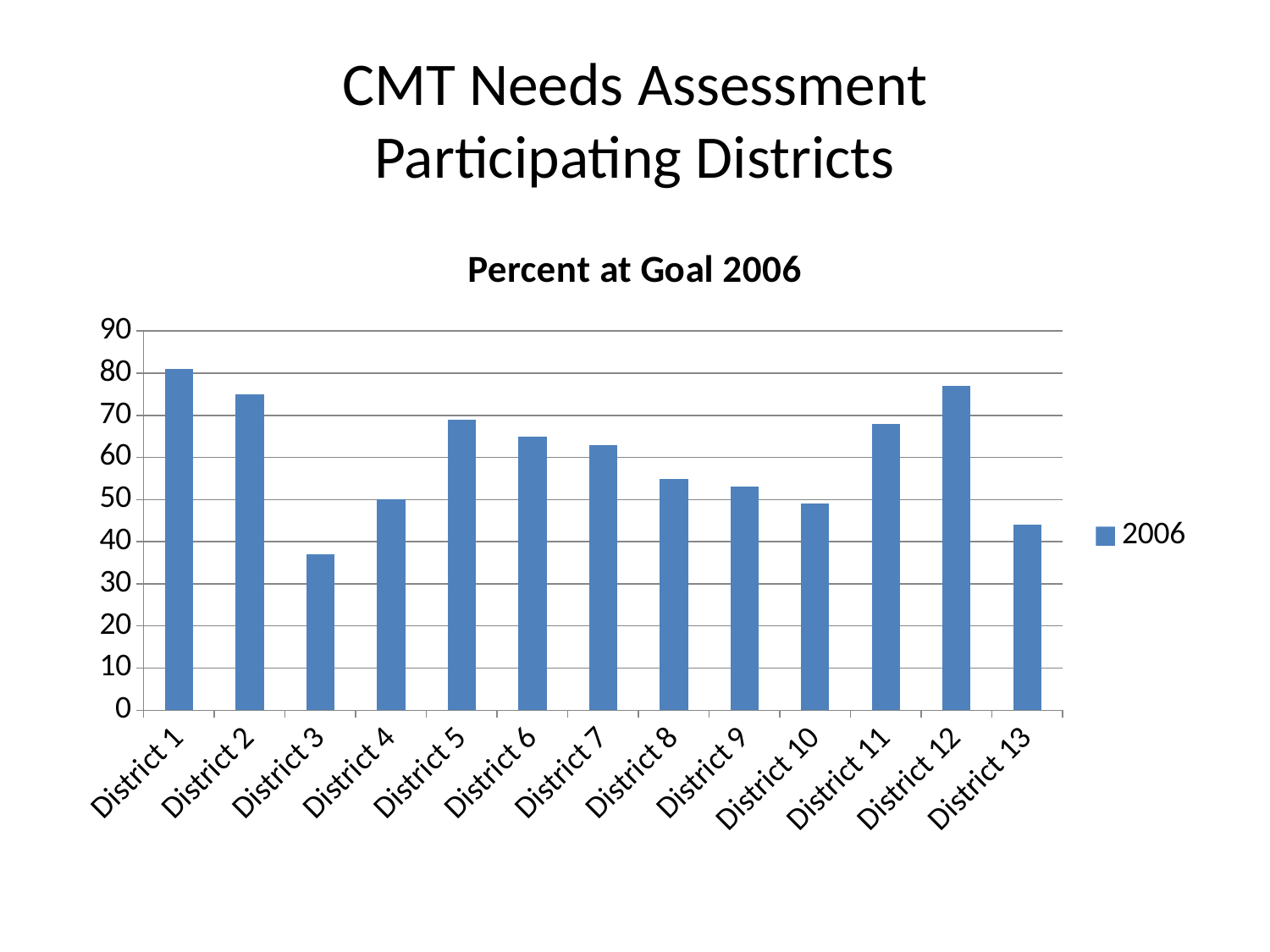
Is the value for District 3 greater or less than 40? less What is the title of the chart? Percent at Goal 2006 What type of chart is shown on the slide? bar chart Is the value for District 13 greater or less than 50? less How many districts are shown on the x axis of the chart? 13 Which has a lower percent at goal, District 10 or District 5? District 10 How many series does the legend list? 1 Which has a higher percent at goal, District 2 or District 8? District 2 Which district has the lowest percent at goal? District 3 Is the value for District 12 greater or less than 70? greater Which district has the highest percent at goal? District 1